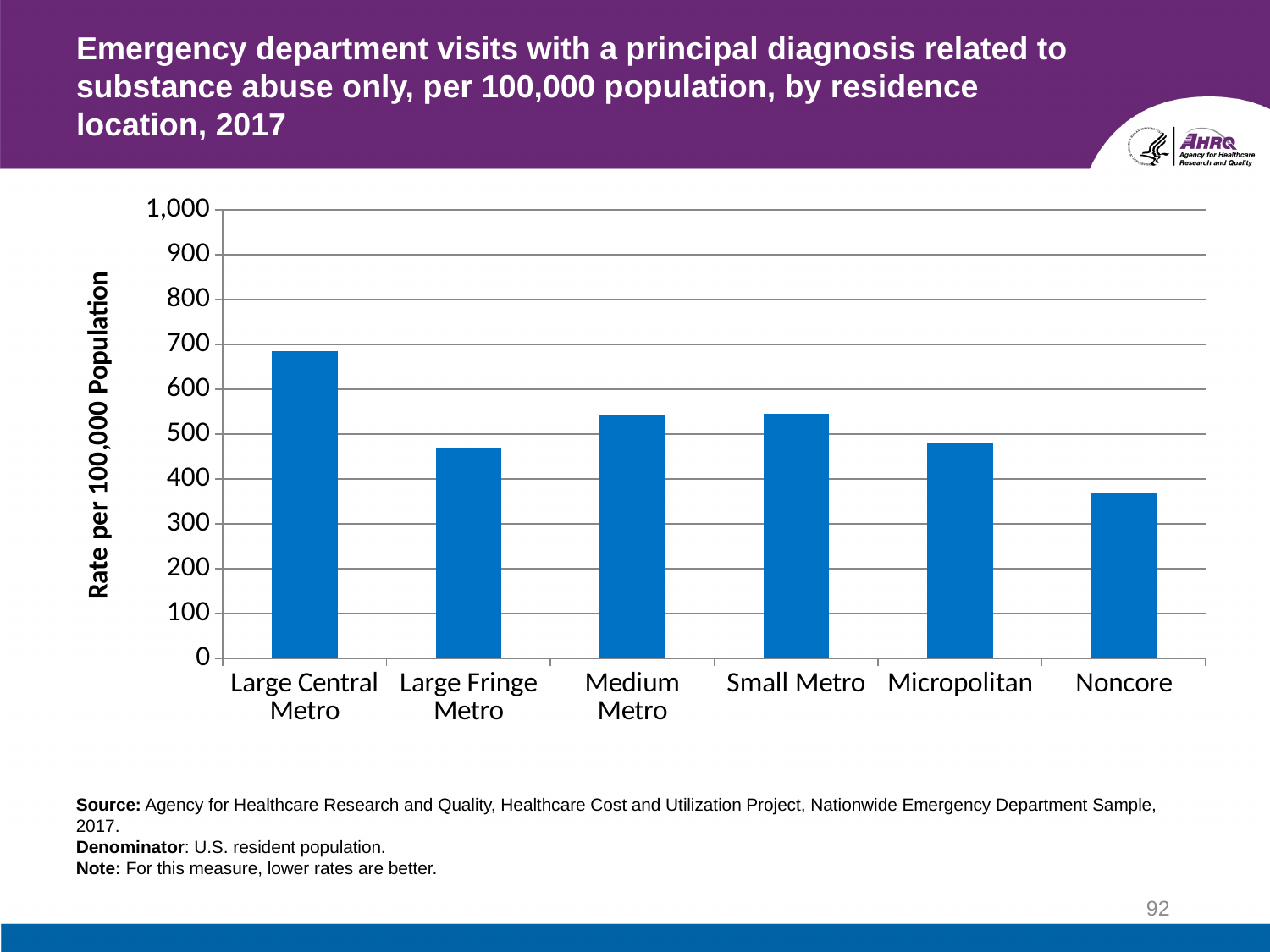
How many residence location categories are shown on the x axis? 6 Which is larger, the value for Noncore or the value for Medium Metro? Medium Metro Which residence location has the lowest rate of emergency department visits? Noncore Which residence location has the highest rate of emergency department visits? Large Central Metro Is the value for Large Fringe Metro greater or less than 500? less Is the value for Large Central Metro greater or less than 600? greater Is the value for Noncore greater or less than 400? less What kind of chart is shown on the slide? bar chart What is the label on the vertical axis of the chart? Rate per 100,000 Population Which is larger, the value for Large Central Metro or the value for Small Metro? Large Central Metro